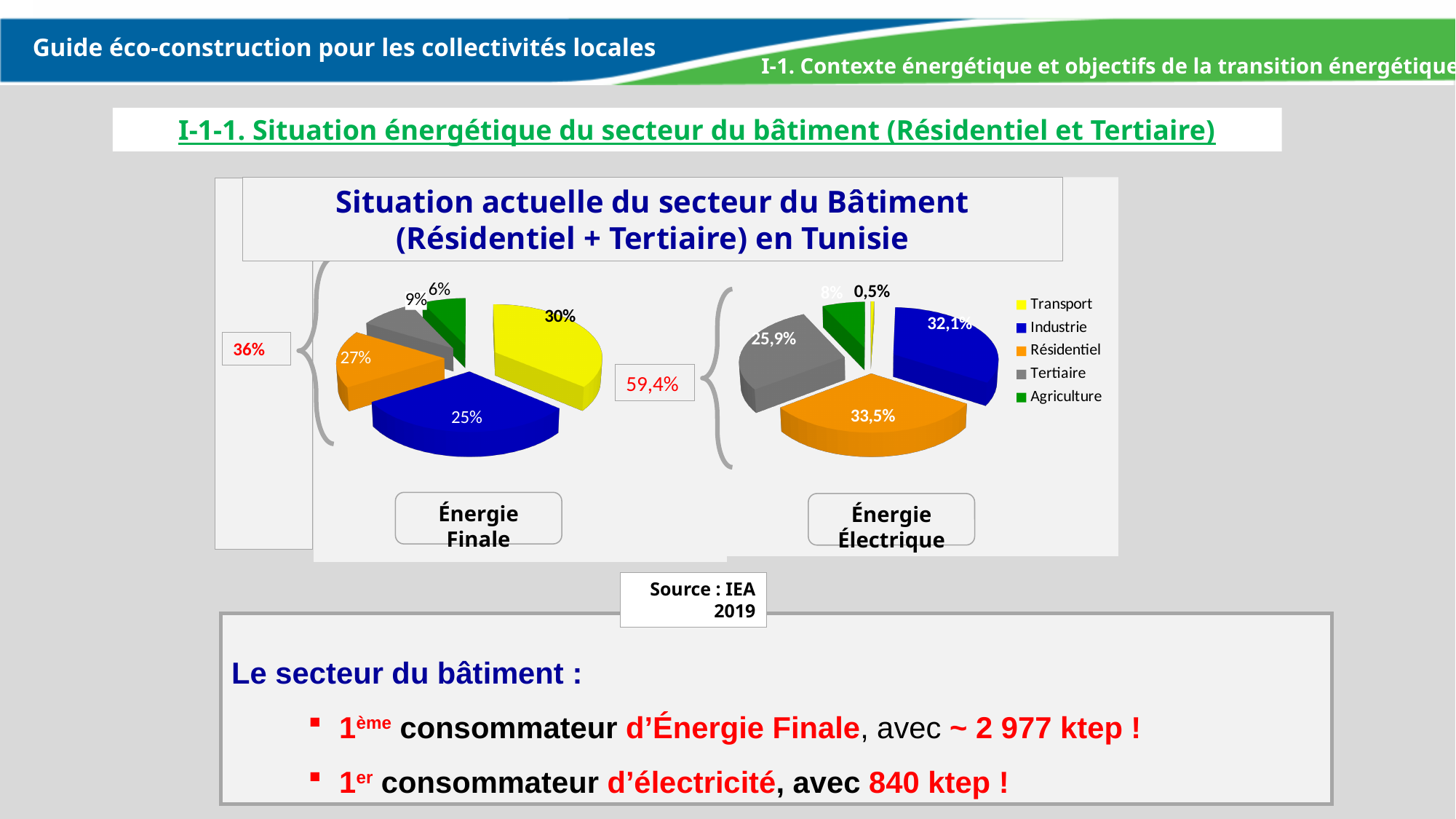
What colour represents Agriculture in the pie charts? Green In the Énergie Électrique pie chart, which sector has the smallest share? Transport How many sectors does the legend list for the pie charts? 5 In the Énergie Électrique pie chart, what share does Tertiaire have? 25,9% What type of charts are shown on the slide? Pie charts In the Énergie Finale pie chart, what share does Transport have? 30% In the Énergie Finale pie chart, what is the difference between the Transport share and the Industrie share? 5% In the Énergie Électrique pie chart, what share does Industrie have? 32,1% In the Énergie Électrique pie chart, which is larger, the share of Résidentiel or the share of Tertiaire? Résidentiel In the Énergie Finale pie chart, what share does Résidentiel have? 27% In the Énergie Finale pie chart, which sector has the smallest share? Agriculture In the Énergie Finale pie chart, which sector has the largest share? Transport